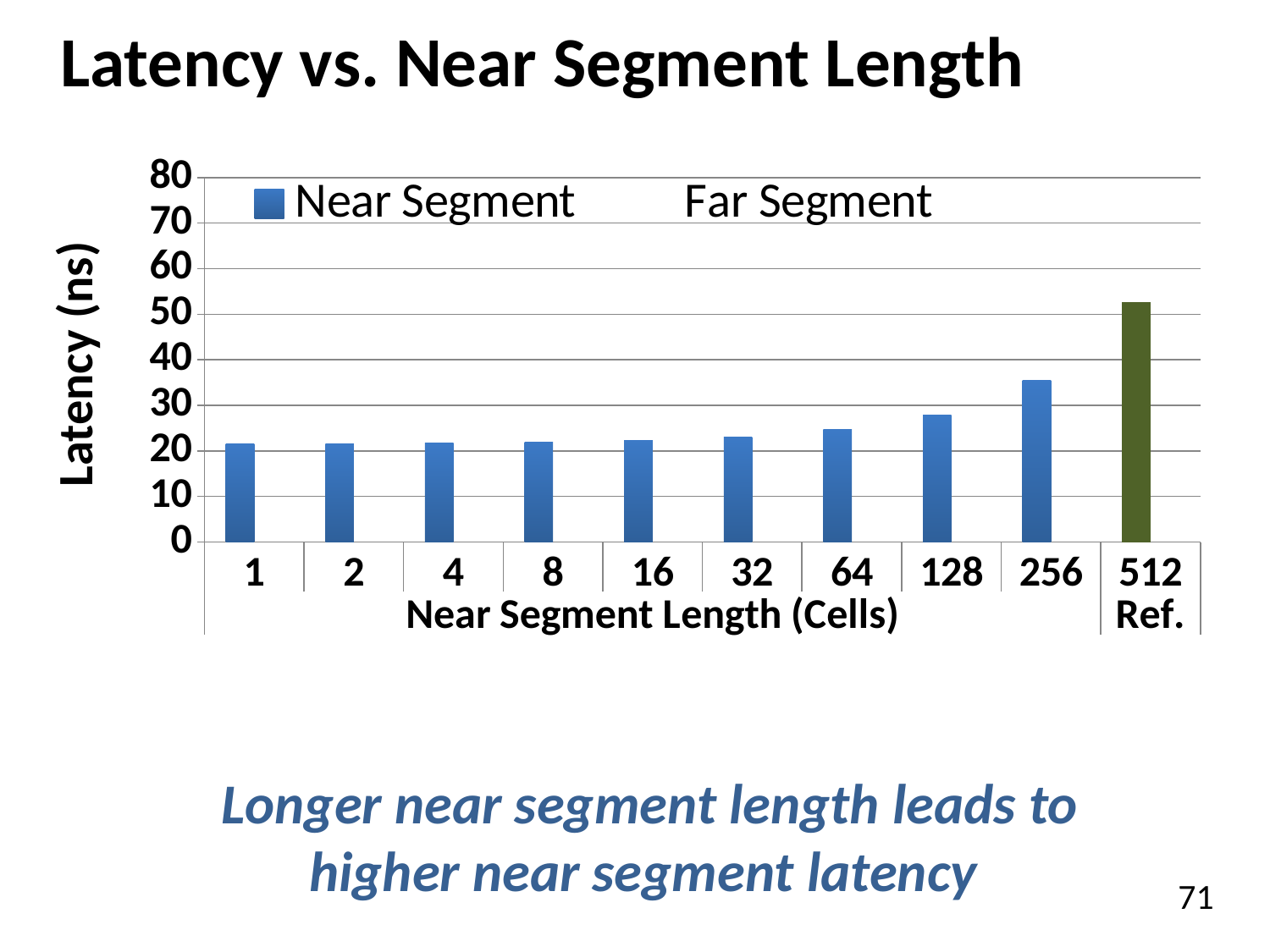
Do the latency values rise or fall as near segment length increases from 1 to 256? rise Is the latency for 512 Ref. greater or less than 50? greater Is the latency for a near segment length of 256 greater or less than 40? less How many series does the legend list? 2 Which category has the highest latency? 512 Ref. Which has the higher latency, 512 Ref. or near segment length 256? 512 Ref. Which has the higher latency, near segment length 256 or 128? 256 Is the latency for a near segment length of 256 greater or less than 30? greater What is the title of the vertical axis? Latency (ns) What kind of chart is shown on the slide? bar chart How many bars are plotted in the chart? 10